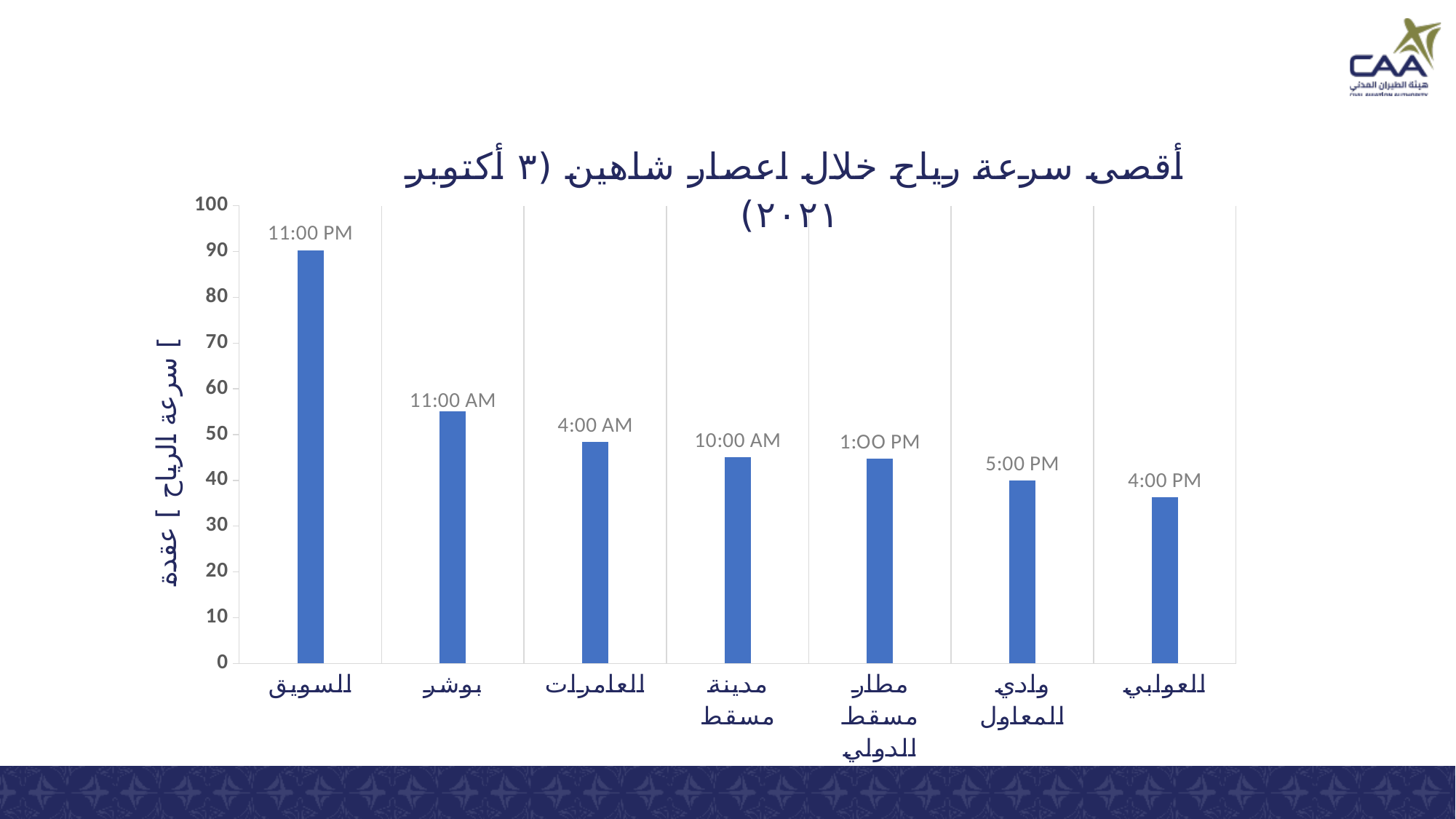
Is the value for بوشر greater or less than 50? greater Is the value for السويق greater or less than 80? greater Which location has the lowest maximum wind speed? العوابي Which location has the highest maximum wind speed? السويق Do the bar values rise or fall moving from left to right along the x axis? fall What kind of chart is shown on the slide? bar chart What time label is printed above the bar for السويق? 11:00 PM What time label is printed above the bar for وادي المعاول? 5:00 PM Is the value for العوابي greater or less than 40? less How many locations (categories) are plotted on the chart? 7 Which has the larger maximum wind speed, السويق or بوشر? السويق